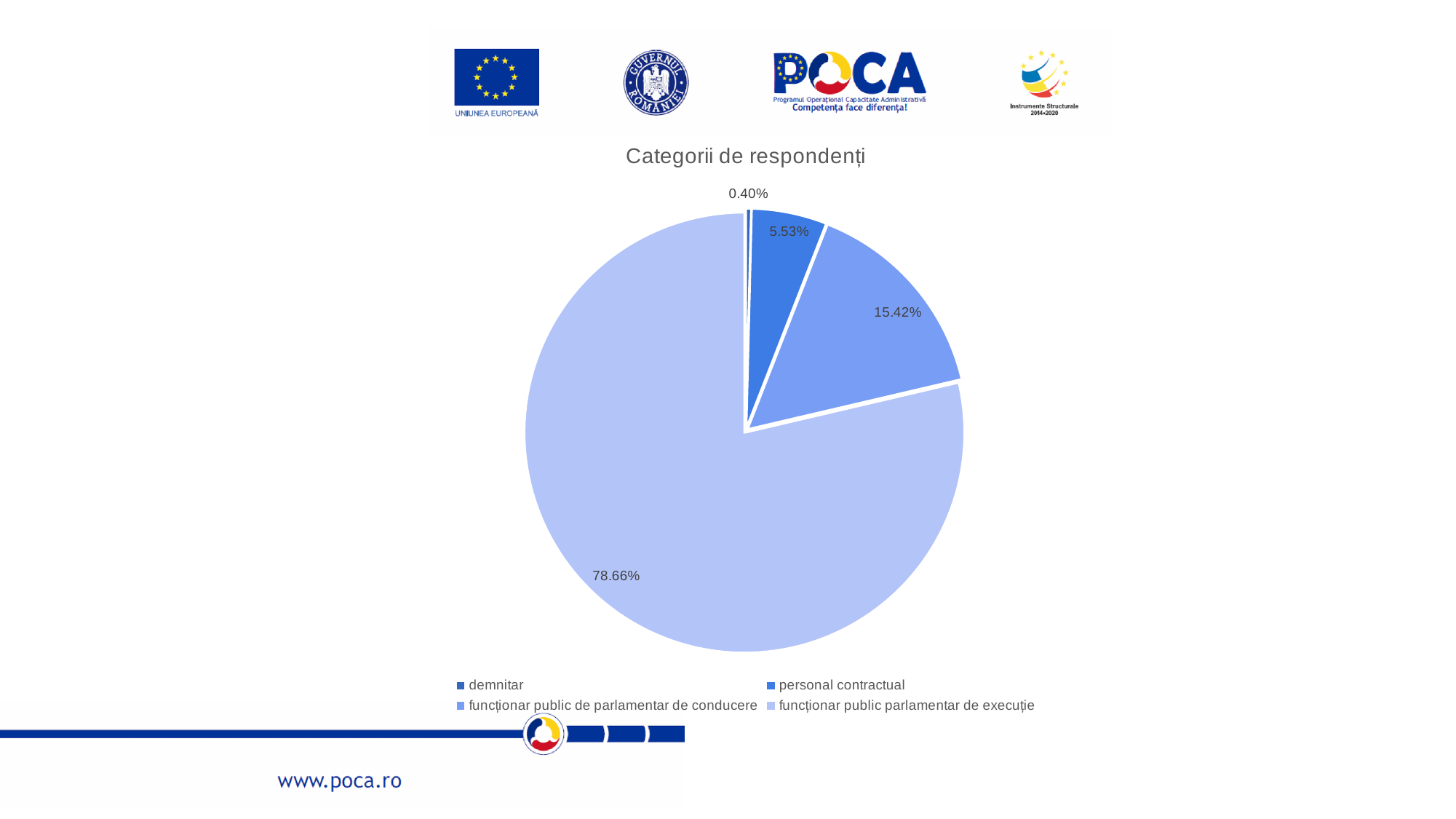
What is the difference between the share for 'funcționar public parlamentar de execuție' and the share for 'funcționar public de parlamentar de conducere'? 63.24% What share of respondents is 'funcționar public de parlamentar de conducere'? 15.42% Which category has the smallest slice of the pie? demnitar Which is larger: the share for 'personal contractual' or the share for 'funcționar public de parlamentar de conducere'? funcționar public de parlamentar de conducere What share of respondents is 'funcționar public parlamentar de execuție'? 78.66% How many categories does the legend list? 4 What is the title of the chart? Categorii de respondenți What share of respondents is 'personal contractual'? 5.53% What kind of chart is shown on the slide? pie chart What is the difference between the share for 'personal contractual' and the share for 'demnitar'? 5.13% Which category has the largest slice of the pie? funcționar public parlamentar de execuție